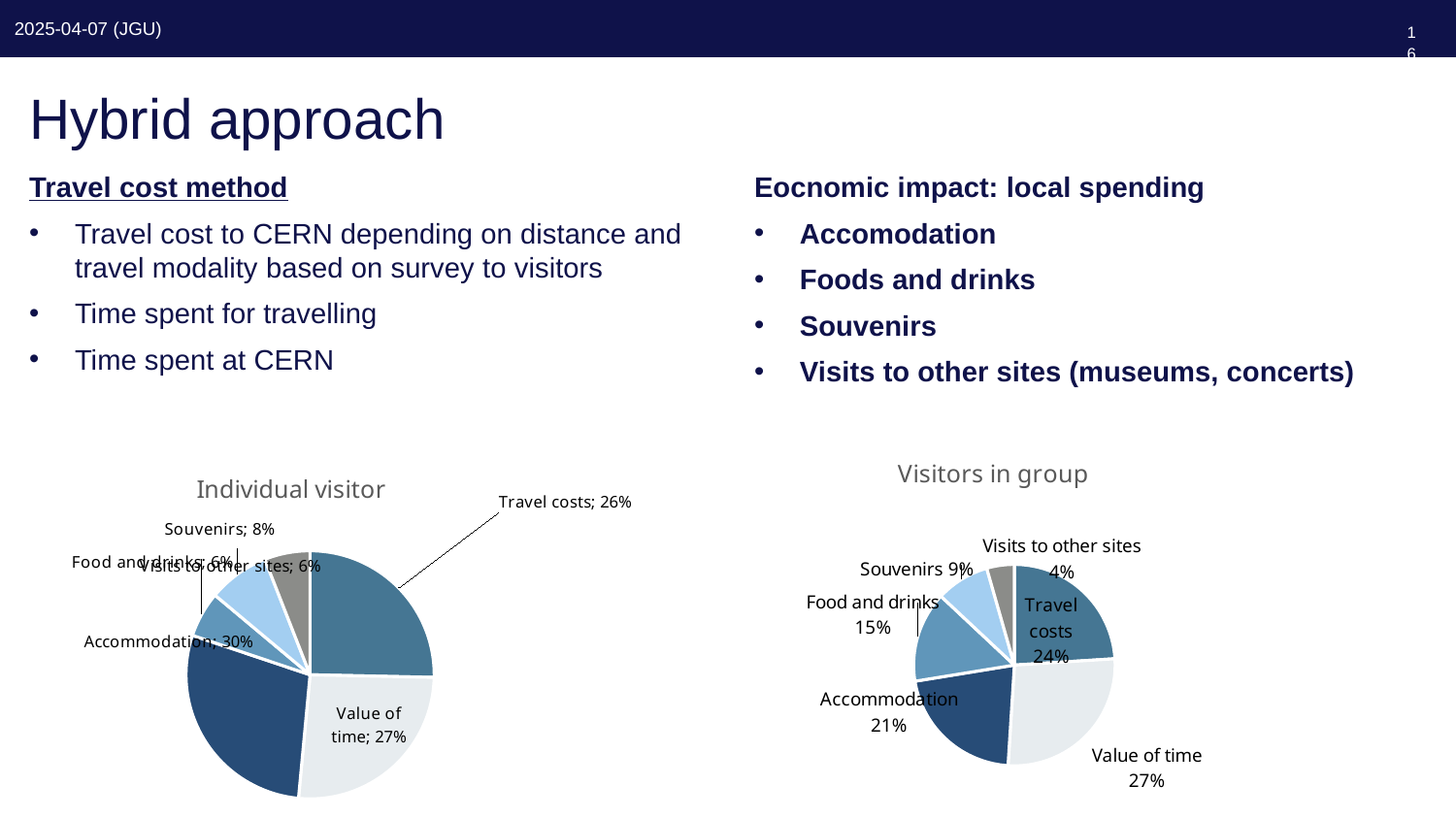
In the 'Visitors in group' chart, which is larger: Travel costs or Accommodation? Travel costs What type of chart is the 'Individual visitor' chart? Pie chart In the 'Individual visitor' chart, which category has the largest share? Accommodation In the 'Visitors in group' chart, what is the difference in percentage points between Value of time and Accommodation? 6 In the 'Visitors in group' chart, what share is Visits to other sites? 4% In the 'Visitors in group' chart, which category has the smallest share? Visits to other sites In the 'Individual visitor' chart, what share is Accommodation? 30% How many slices does the 'Visitors in group' chart have? 6 In the 'Visitors in group' chart, which category has the largest share? Value of time In the 'Visitors in group' chart, what share is Food and drinks? 15% In the 'Individual visitor' chart, what share is Souvenirs? 8% In the 'Individual visitor' chart, what share is Travel costs? 26%